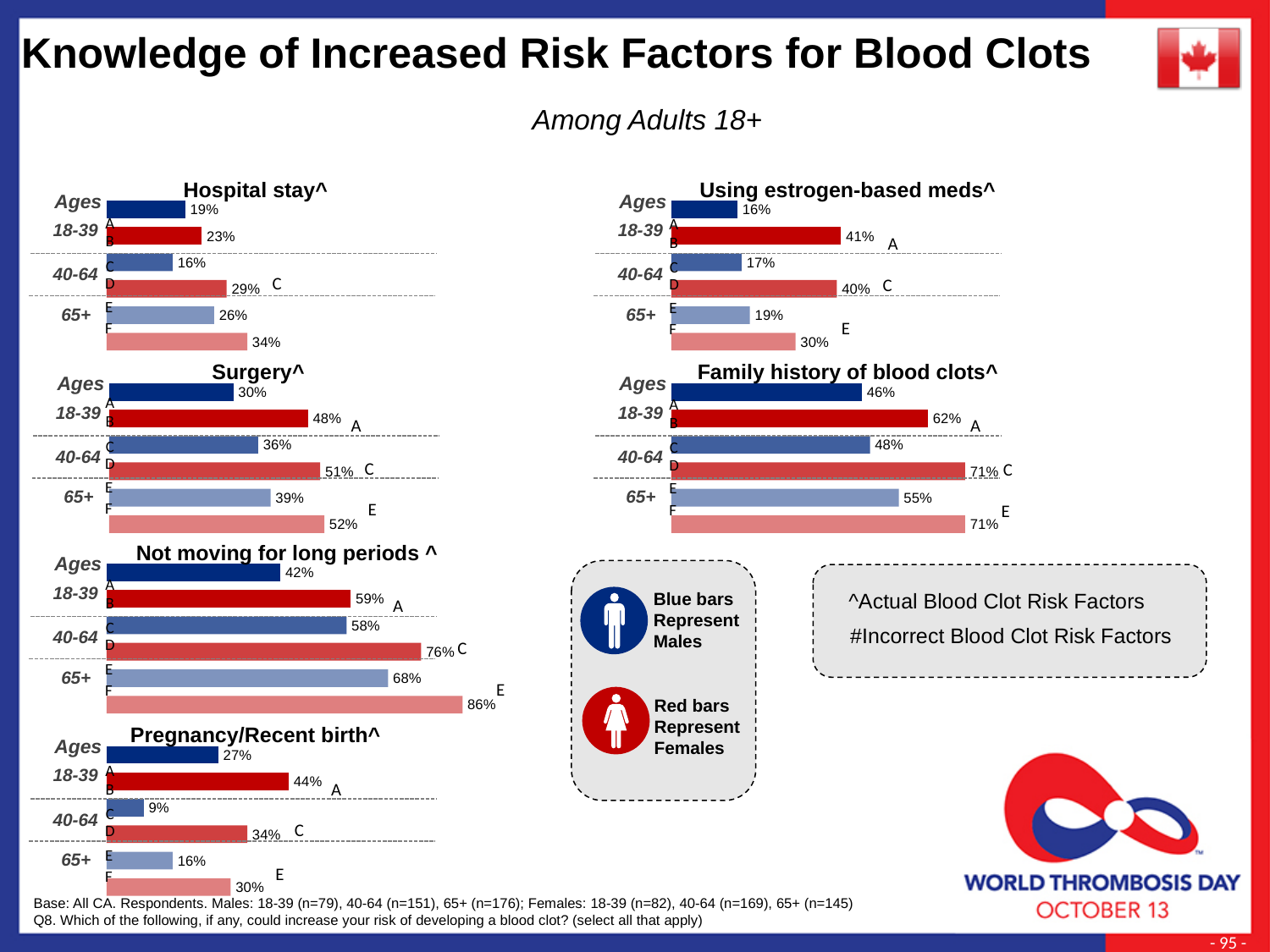
In the 'Using estrogen-based meds^' chart, what is the difference between females aged 18-39 and males aged 18-39? 25 percentage points In the 'Not moving for long periods ^' chart, do the male values rise or fall from ages 18-39 to 65+? Rise In the 'Surgery^' chart, what is the value for males aged 65+? 39% In the 'Family history of blood clots^' chart, what is the value for females aged 40-64? 71% In the 'Pregnancy/Recent birth^' chart, what is the difference between females aged 18-39 and males aged 18-39? 17 percentage points In the 'Not moving for long periods ^' chart, which age group and gender has the highest value? Females 65+ (86%) How many age groups are shown in the 'Hospital stay^' chart? 3 According to the legend on the slide, what do the red bars represent? Females In the 'Family history of blood clots^' chart, which is larger: males aged 65+ or males aged 40-64? Males aged 65+ What type of chart is used for 'Surgery^'? Bar chart In the 'Pregnancy/Recent birth^' chart, which age group and gender has the lowest value? Males 40-64 (9%) In the 'Hospital stay^' chart, what is the value for females aged 40-64? 29%